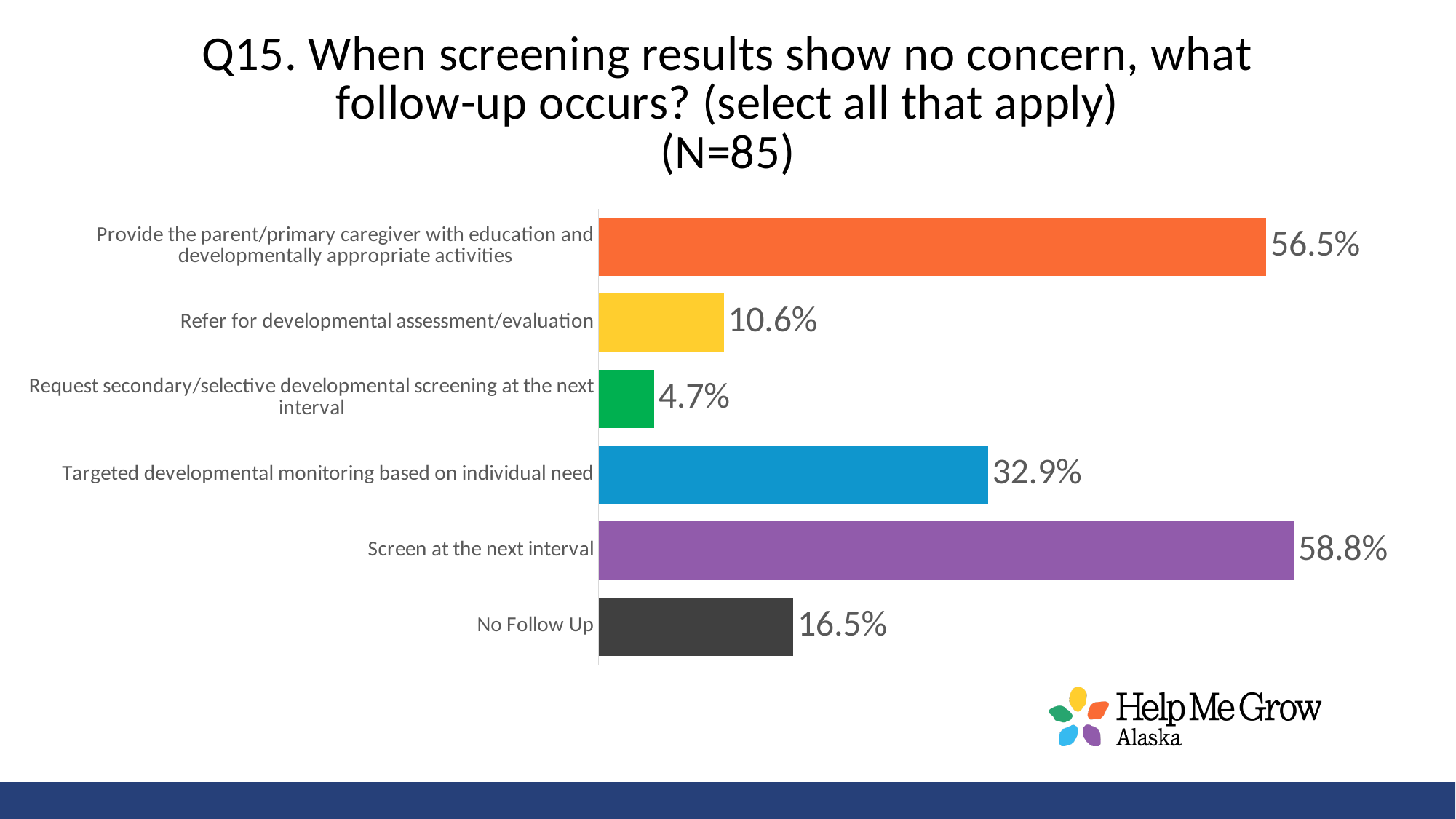
What is the value for "Refer for developmental assessment/evaluation"? 10.6% What percentage is shown for "Targeted developmental monitoring based on individual need"? 32.9% What is the value for "No Follow Up"? 16.5% What is the difference between "Screen at the next interval" and "Provide the parent/primary caregiver with education and developmentally appropriate activities"? 2.3% How many follow-up options are shown in the chart? 6 What is the sample size (N) stated in the chart title? 85 Which follow-up option has the highest percentage? Screen at the next interval What percentage of respondents selected "Screen at the next interval"? 58.8% What is the difference between "Targeted developmental monitoring based on individual need" and "No Follow Up"? 16.4% Which is larger: "No Follow Up" or "Refer for developmental assessment/evaluation"? No Follow Up Which follow-up option has the lowest percentage? Request secondary/selective developmental screening at the next interval What type of chart is shown on the slide? Bar chart